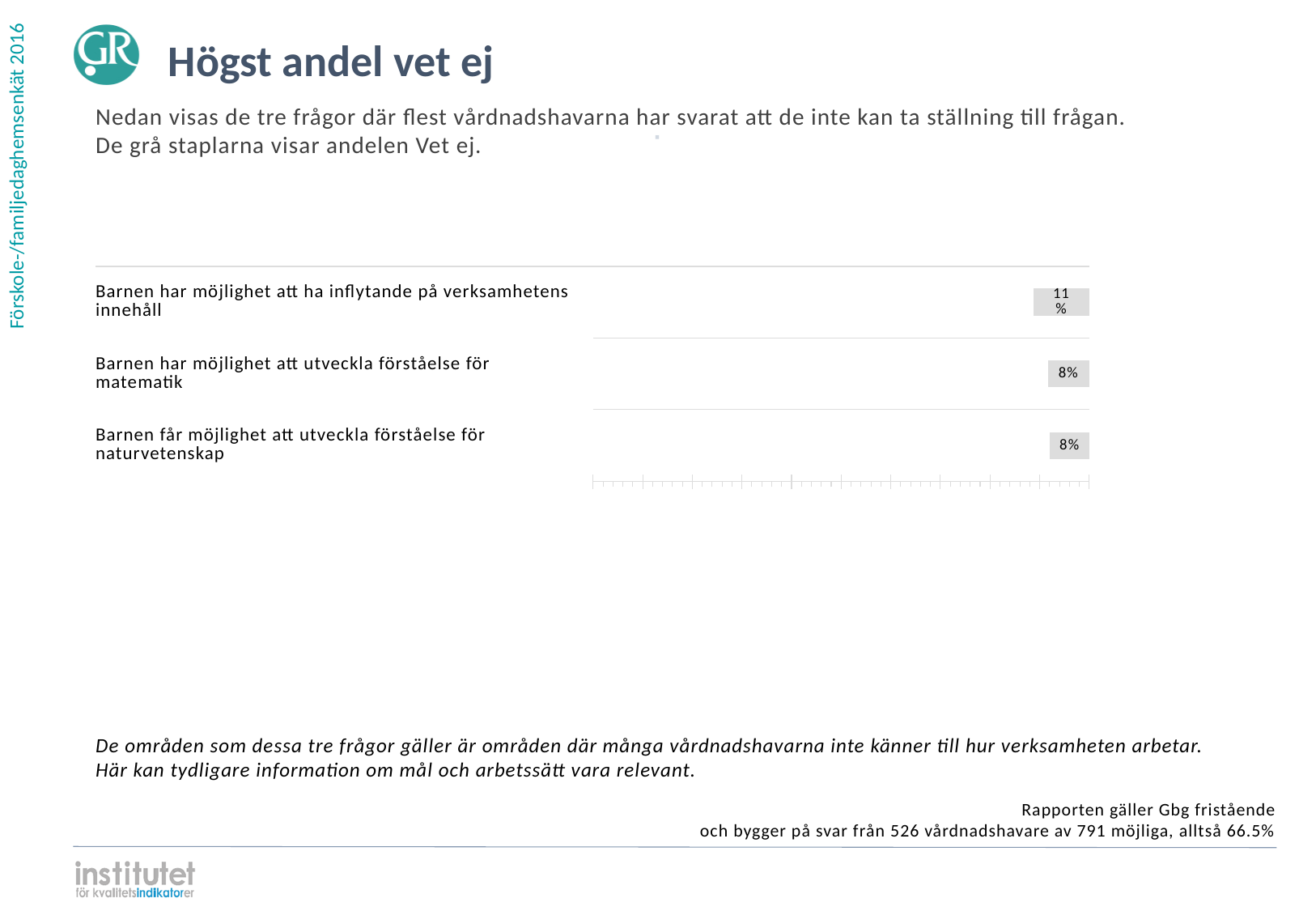
Which has a larger Vet ej share: the question about inflytande på verksamhetens innehåll or the question about naturvetenskap? Barnen har möjlighet att ha inflytande på verksamhetens innehåll Which question has the highest share of Vet ej answers? Barnen har möjlighet att ha inflytande på verksamhetens innehåll What is the difference in Vet ej share between the question about inflytande på verksamhetens innehåll and the question about matematik? 3 percentage points What is the Vet ej share for "Barnen har möjlighet att ha inflytande på verksamhetens innehåll"? 11% What colour are the bars in the chart? Grey What is the Vet ej share for "Barnen får möjlighet att utveckla förståelse för naturvetenskap"? 8% How many questions are shown in the chart? 3 What kind of chart is shown on the slide? Bar chart What is the Vet ej share for "Barnen har möjlighet att utveckla förståelse för matematik"? 8% Do the questions about matematik and naturvetenskap have the same Vet ej share? Yes, both 8% What is the title of the slide containing the chart? Högst andel vet ej